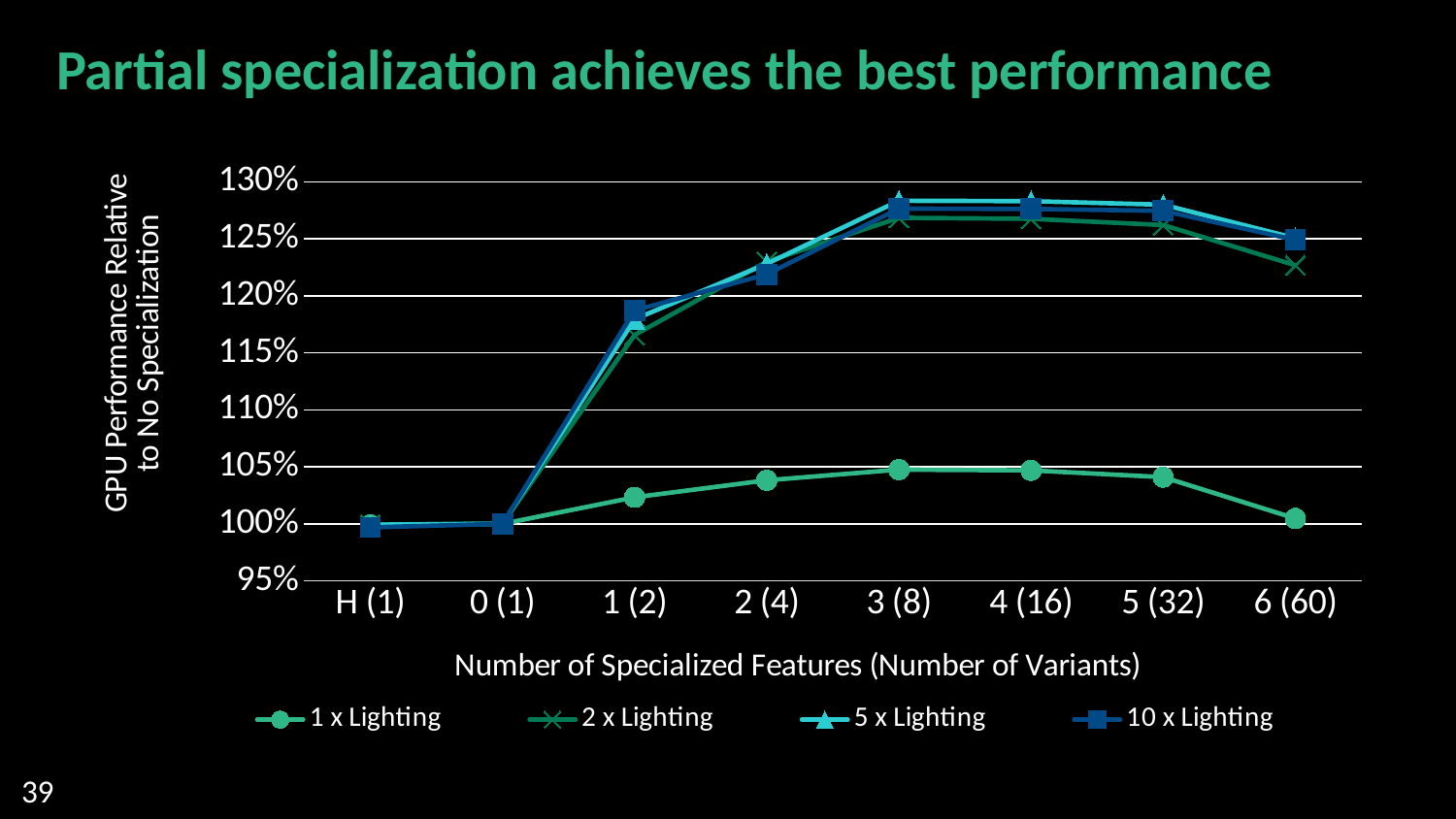
How many categories are shown on the x axis? 8 Is the value for 2 x Lighting at 6 (60) greater or less than 125%? less Is the value for 10 x Lighting at 1 (2) greater or less than 115%? greater Do the values for 1 x Lighting rise or fall from 4 (16) to 6 (60)? fall What is the title of the chart's x axis? Number of Specialized Features (Number of Variants) What is the title of the chart's y axis? GPU Performance Relative to No Specialization Which series has the lowest value at 3 (8)? 1 x Lighting How many series does the legend list? 4 For 10 x Lighting, which is larger: the value at 1 (2) or the value at 2 (4)? 2 (4) Is the value for 5 x Lighting at 3 (8) greater or less than 125%? greater What kind of chart is shown on the slide? line chart